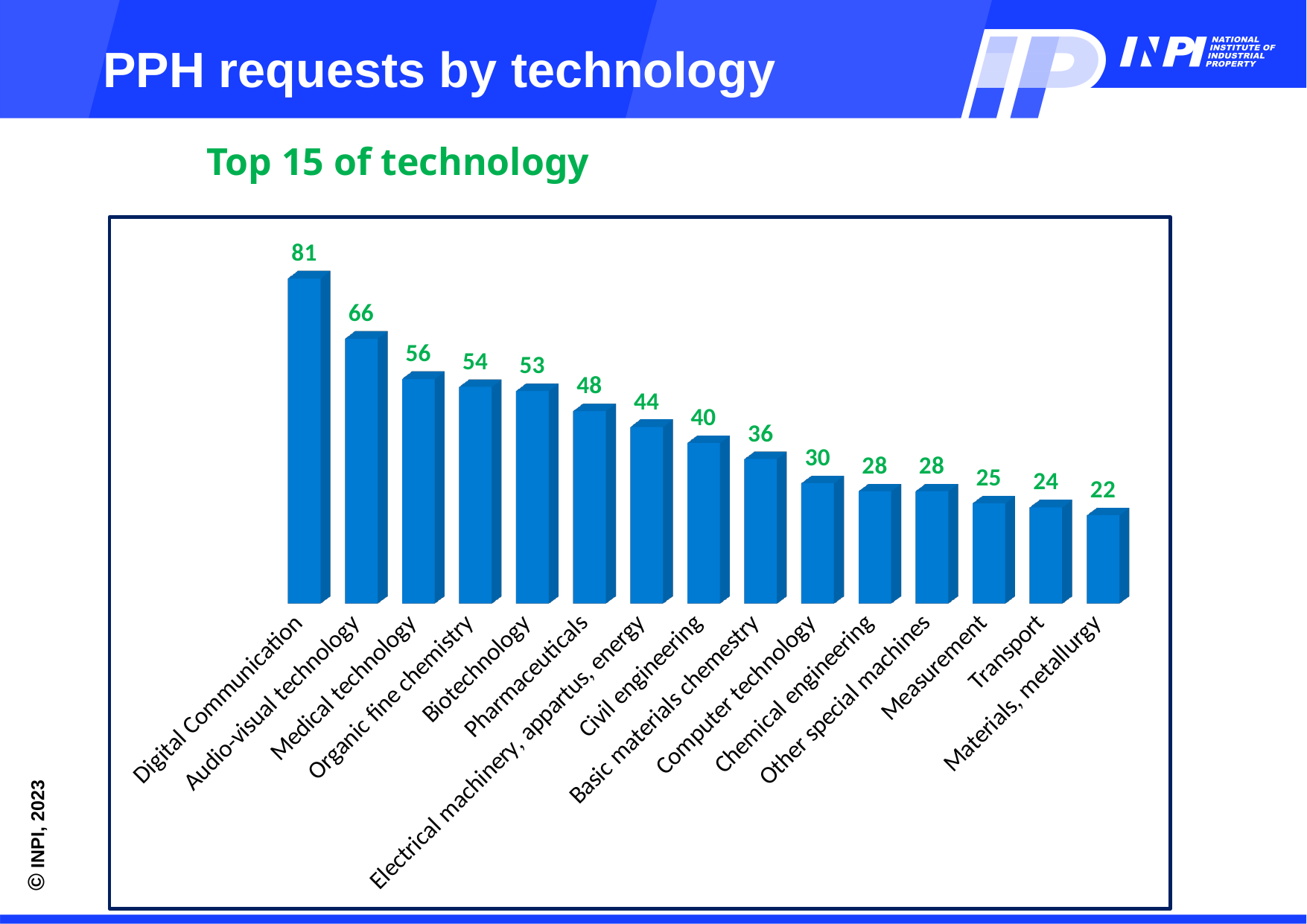
What is the value for Civil engineering? 40 Which is larger, the value for Medical technology or the value for Organic fine chemistry? Medical technology What is the value for Biotechnology? 53 What is the value for Digital Communication? 81 How many technology categories are shown in the chart? 15 Which technology has the highest number of PPH requests? Digital Communication What is the difference between the values for Pharmaceuticals and Computer technology? 18 What is the value for Transport? 24 What is the difference between the values for Digital Communication and Audio-visual technology? 15 What kind of chart is shown on the slide? Bar chart Do the values rise or fall from left to right along the x axis? Fall Which technology has the lowest number of PPH requests? Materials, metallurgy